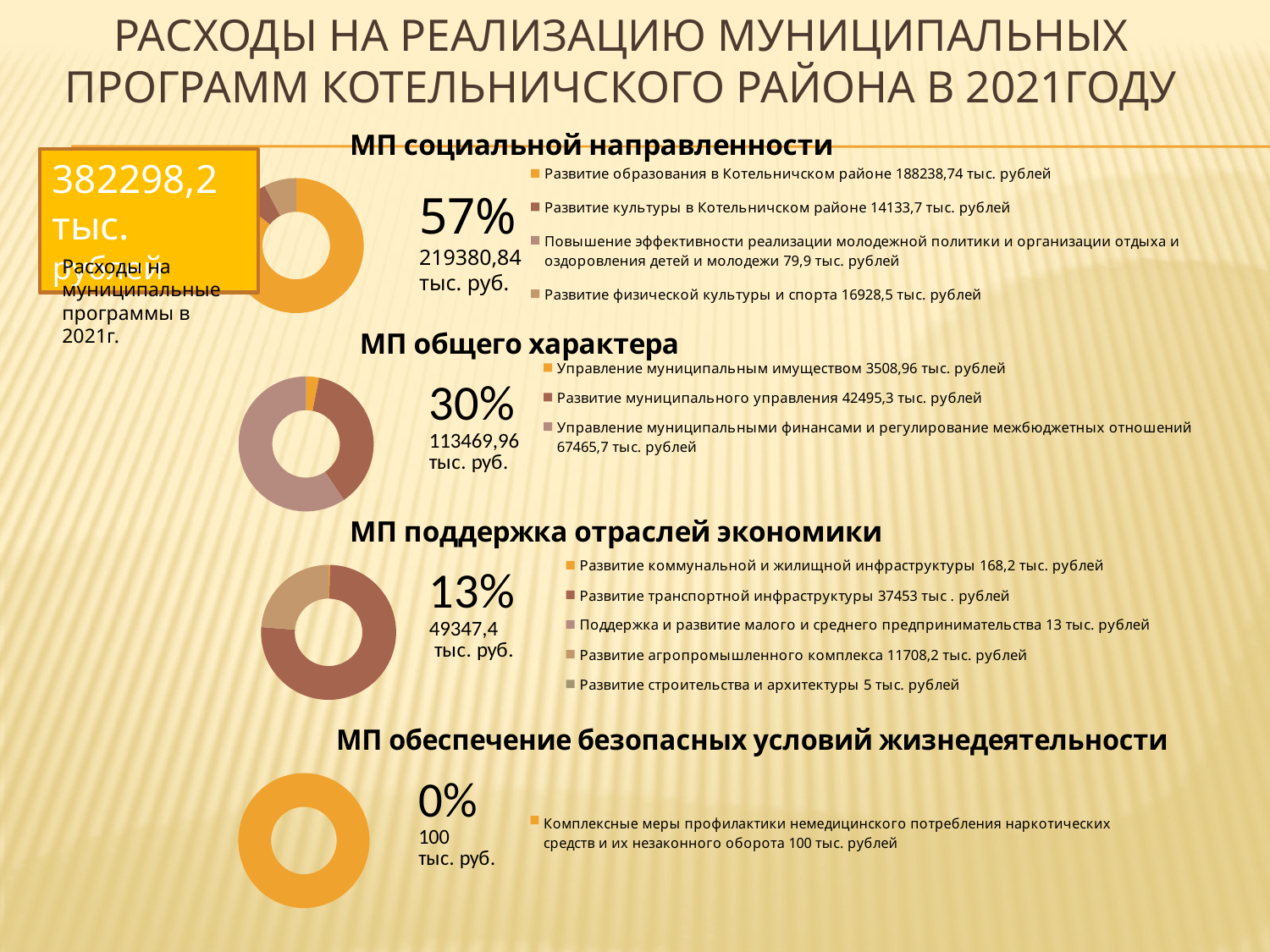
In the chart 'МП общего характера', what is the value for 'Развитие муниципального управления'? 42495,3 тыс. рублей In the chart 'МП обеспечение безопасных условий жизнедеятельности', what is the total amount printed next to the chart? 100 тыс. руб. In the chart 'МП социальной направленности', what is the value for 'Развитие образования в Котельничском районе'? 188238,74 тыс. рублей In the chart 'МП общего характера', which legend entry has the highest value? Управление муниципальными финансами и регулирование межбюджетных отношений In the chart 'МП социальной направленности', what is the difference between 'Развитие образования в Котельничском районе' and 'Развитие культуры в Котельничском районе'? 174105,04 тыс. рублей In the chart 'МП социальной направленности', what share of total expenditure does this group represent, as printed next to the chart? 57% What kind of chart is used for 'МП общего характера'? Doughnut (pie) chart In the chart 'МП поддержка отраслей экономики', which is larger: 'Развитие транспортной инфраструктуры' or 'Развитие агропромышленного комплекса'? Развитие транспортной инфраструктуры In the chart 'МП социальной направленности', which legend entry has the lowest value? Повышение эффективности реализации молодежной политики и организации отдыха и оздоровления детей и молодежи In the chart 'МП общего характера', how many entries does the legend list? 3 In the chart 'МП поддержка отраслей экономики', what is the value for 'Развитие агропромышленного комплекса'? 11708,2 тыс. рублей In the chart 'МП поддержка отраслей экономики', how many entries does the legend list? 5